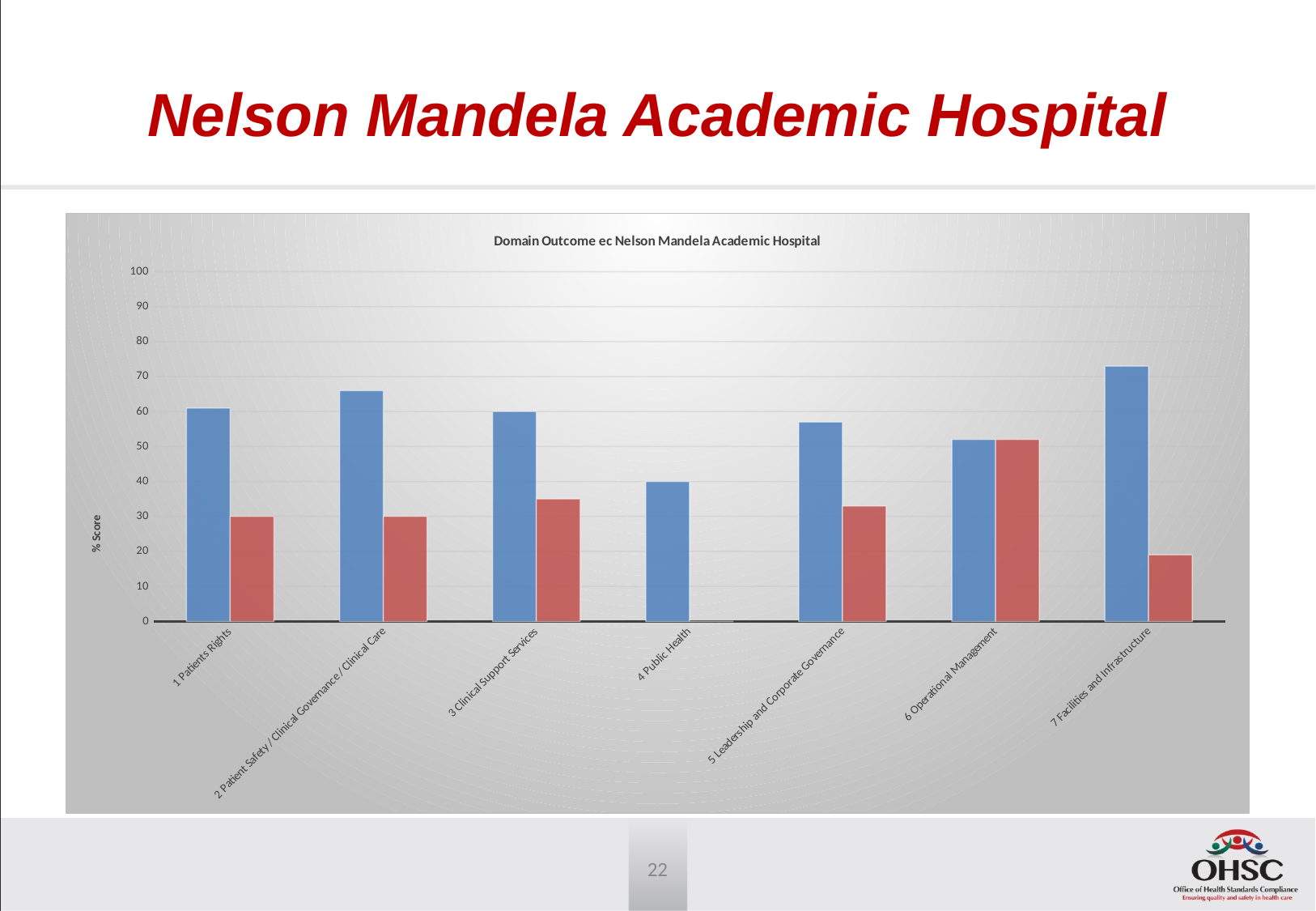
What is the title of the chart? Domain Outcome ec Nelson Mandela Academic Hospital Is the blue bar for 7 Facilities and Infrastructure greater or less than 60? greater Which category shows no visible red bar? 4 Public Health What kind of chart is shown on the slide? bar chart Which category has the tallest blue bar? 7 Facilities and Infrastructure Is the red bar for 7 Facilities and Infrastructure greater or less than 30? less Is the red bar for 6 Operational Management greater or less than 40? greater Which is larger, the blue bar for 1 Patients Rights or the blue bar for 4 Public Health? 1 Patients Rights Which category has the tallest red bar? 6 Operational Management Which category has the shortest blue bar? 4 Public Health How many domain categories are shown on the x axis of the chart? 7